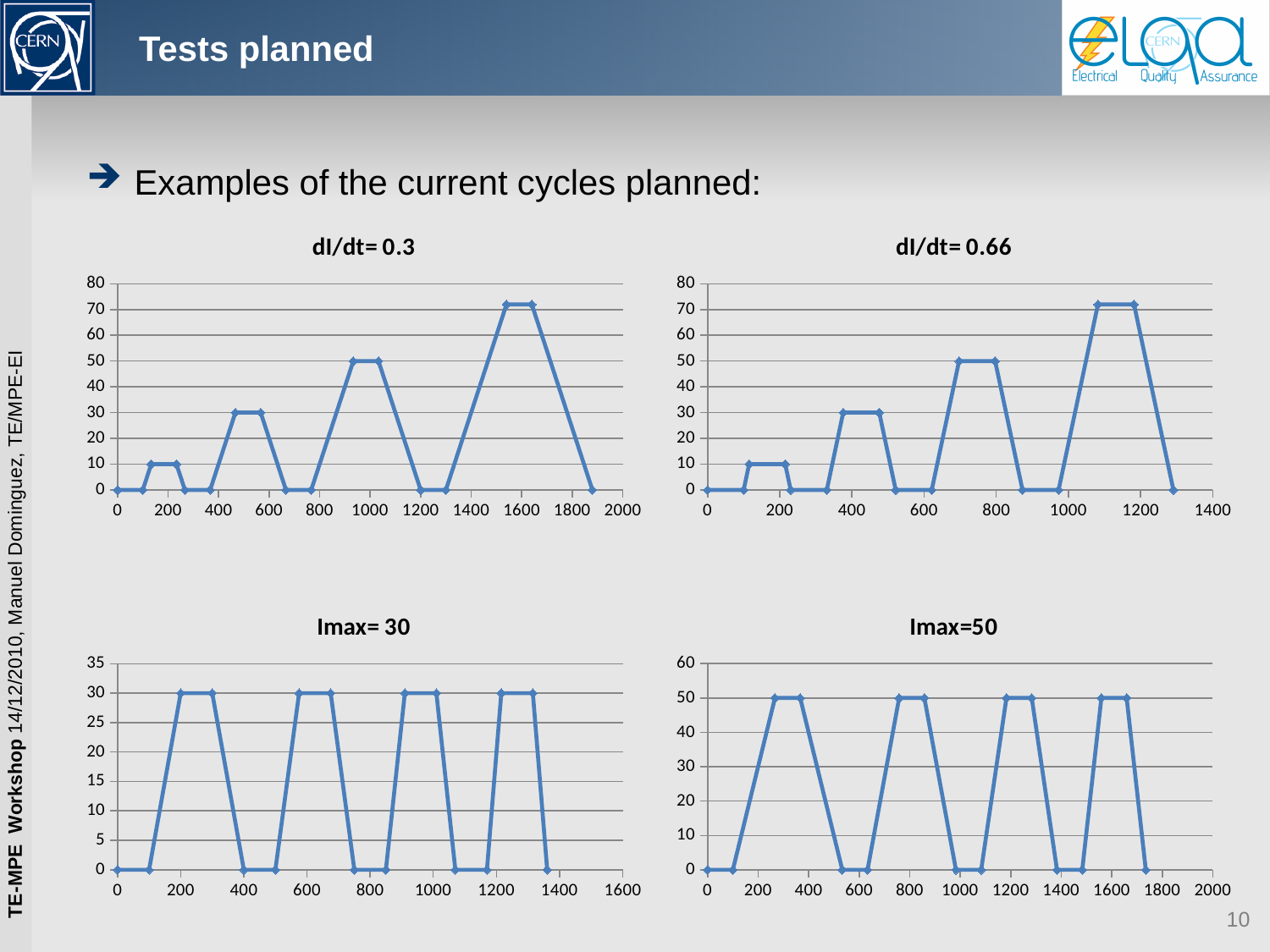
In the 'dI/dt= 0.3' chart, is the highest peak greater or less than 70? greater In the 'Imax= 30' chart, what value do the plateaus reach? 30 In the 'Imax= 30' chart, how many plateaus at 30 are there? 4 In the 'dI/dt= 0.66' chart, do the plateau heights rise or fall from left to right? rise In the 'dI/dt= 0.66' chart, is the highest peak greater or less than 80? less How many charts are shown on the slide? 4 What kind of chart is the 'dI/dt= 0.3' chart? line chart What is the title of the top-right chart? dI/dt= 0.66 In the 'dI/dt= 0.3' chart, what is the value of the first plateau? 10 In the 'dI/dt= 0.66' chart, what is the value of the third plateau? 50 In the 'dI/dt= 0.3' chart, is the second plateau higher or lower than the third plateau? lower In the 'Imax=50' chart, what value do the plateaus reach? 50